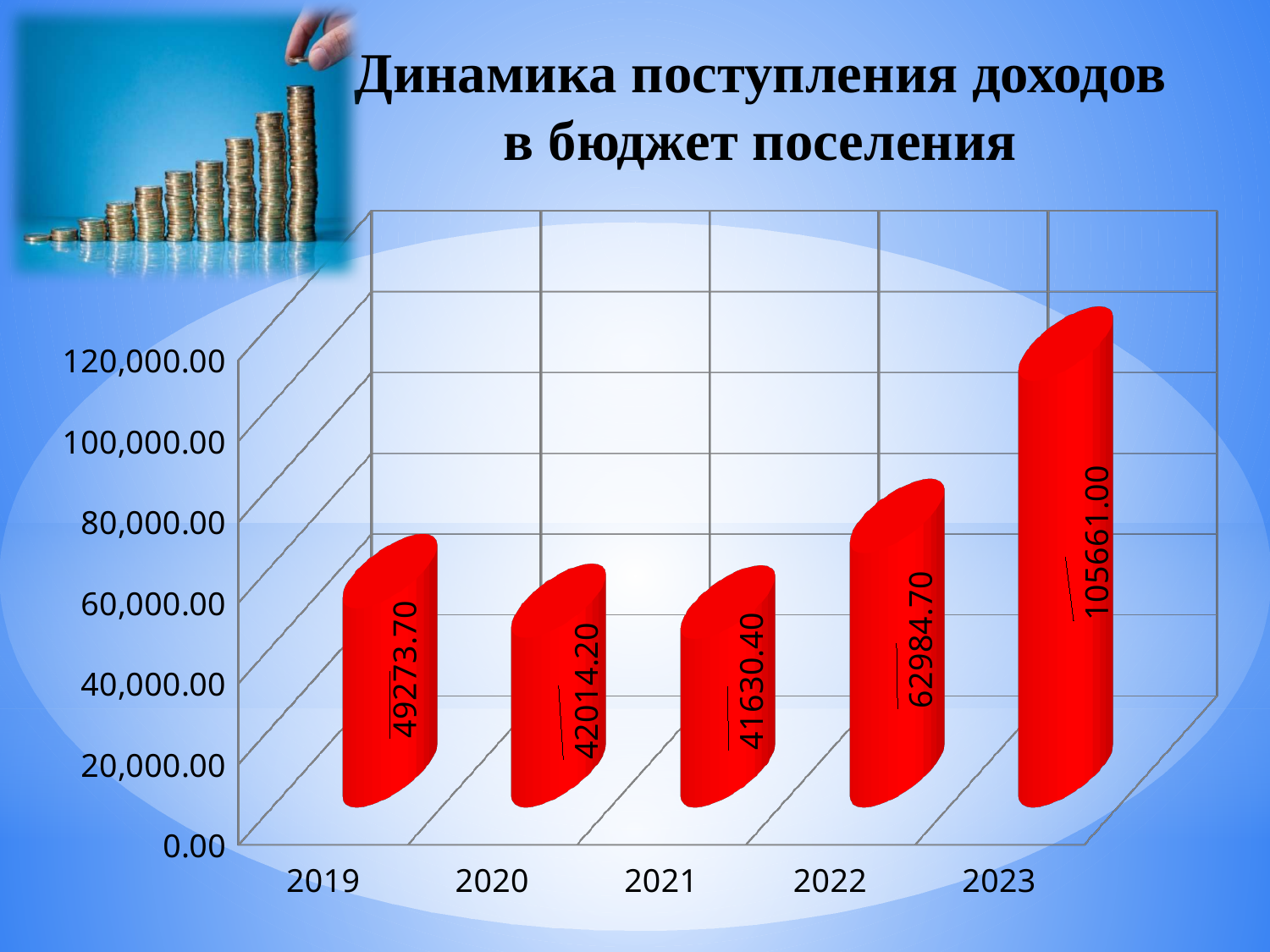
How many years are shown on the x axis? 5 Is the value for 2023 greater or less than 100,000.00? greater Which year has the highest value? 2023 Which year has the lowest value? 2021 What kind of chart is shown on the slide? bar chart What is the difference between the values for 2023 and 2022? 42676.30 What is the value for 2023? 105661.00 What is the value for 2019? 49273.70 What is the value for 2022? 62984.70 Which is larger, the value for 2020 or the value for 2021? 2020 Do the values rise or fall from 2021 to 2023? rise What is the difference between the values for 2019 and 2020? 7259.50